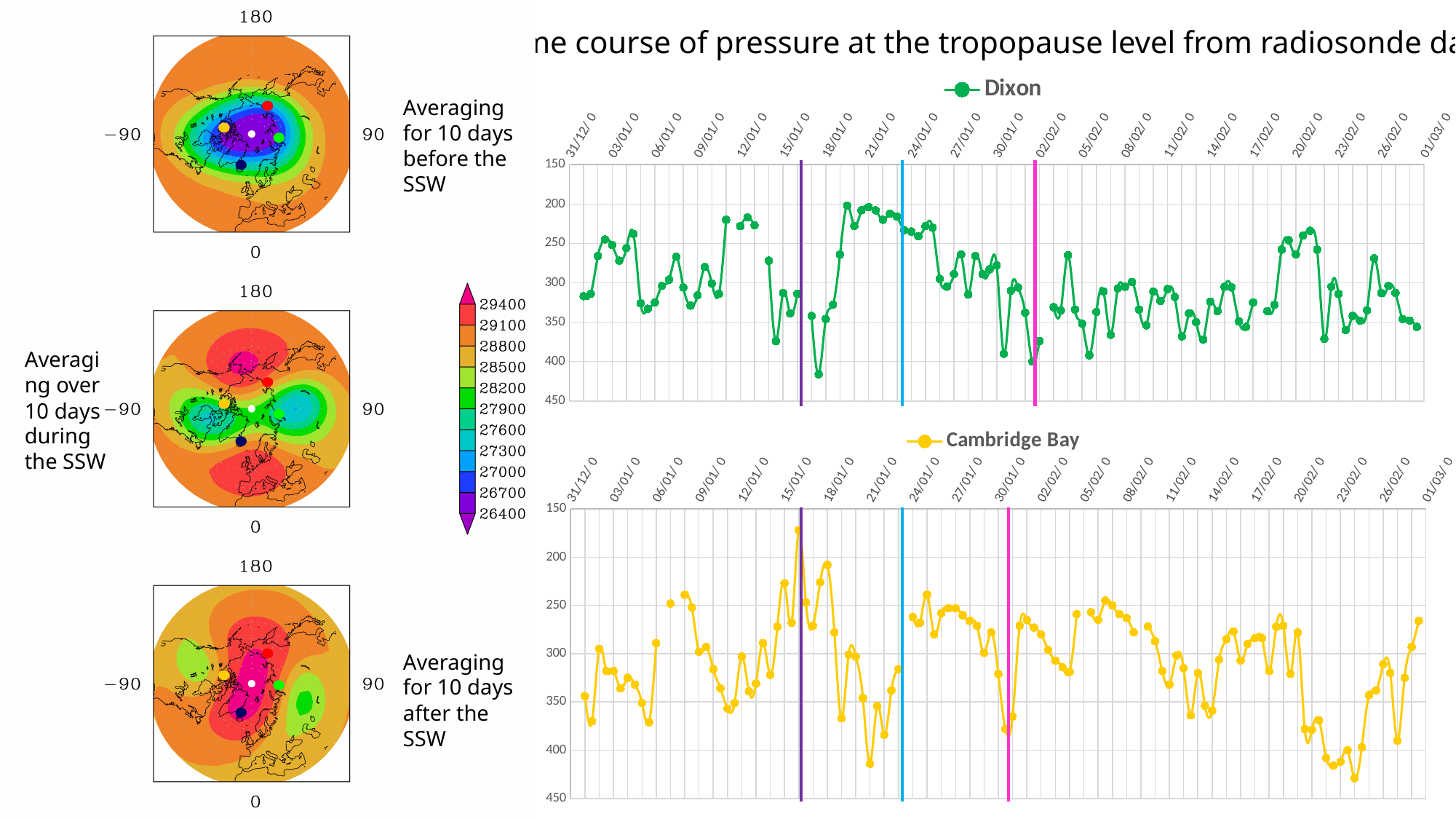
What kind of chart is the Cambridge Bay chart? line chart In the Cambridge Bay chart, is the lowest point of the line (around 24/02) greater or less than 400? greater In the Dixon chart, what is the name of the series shown in the legend? Dixon What is the first date label on the x axis of the Dixon chart? 31/12/ 0 In the Cambridge Bay chart, is the value at 31/12 greater or less than 300? greater What kind of chart is the Dixon chart? line chart In the Cambridge Bay chart, is the highest peak of the line (around 15/01) greater or less than 200? less How many series does the legend of the Cambridge Bay chart list? 1 How many series does the legend of the Dixon chart list? 1 In the Cambridge Bay chart, what colour is the plotted line? yellow